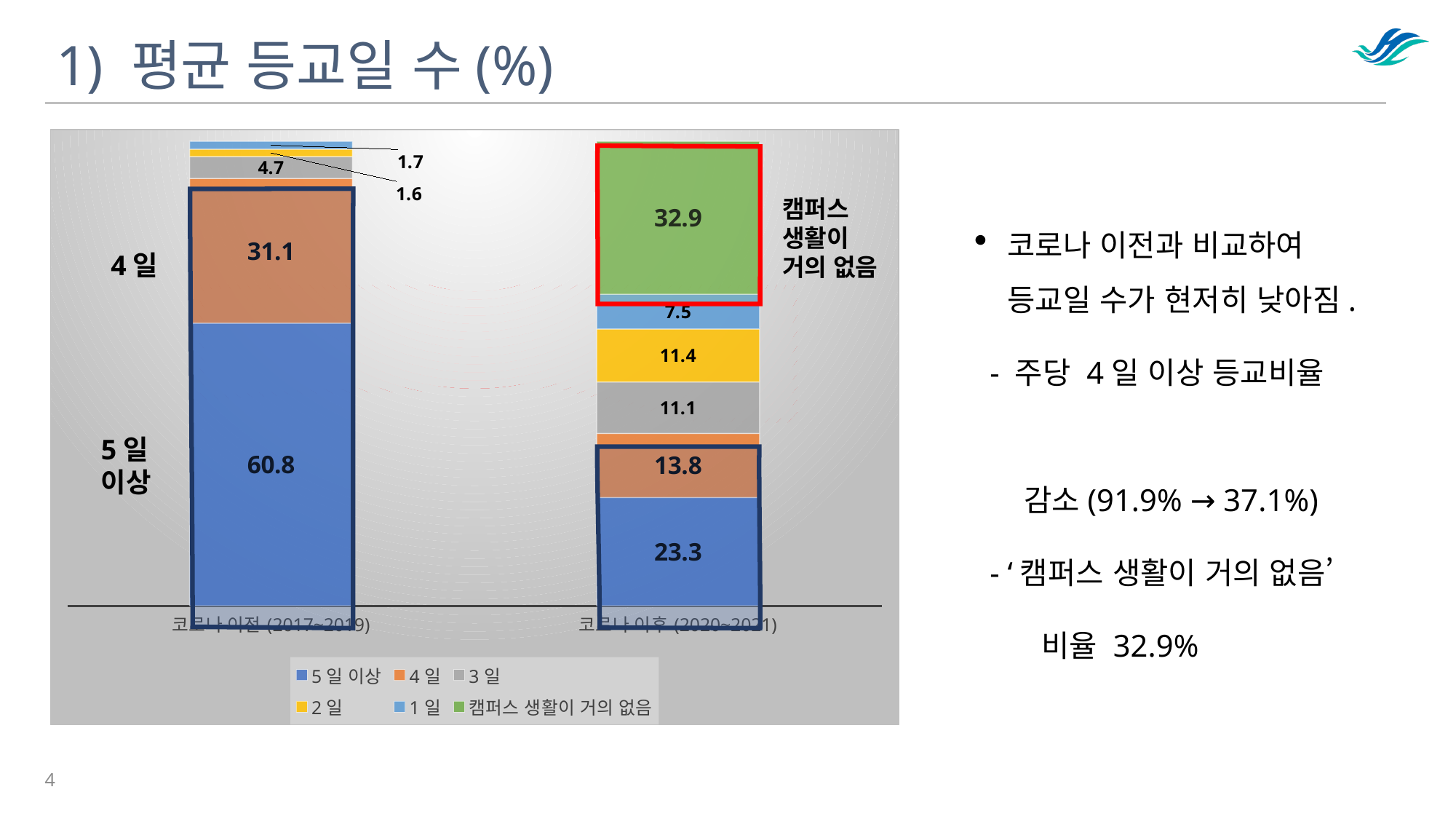
By how much did the 5 일 이상 value fall from 코로나 이전 (2017~2019) to 코로나 이후 (2020~2021)? 37.5 What is the value of the 5 일 이상 segment for 코로나 이전 (2017~2019)? 60.8 What is the value of the 4 일 segment for 코로나 이후 (2020~2021)? 13.8 In the 코로나 이후 (2020~2021) bar, which is larger: the 2 일 segment or the 3 일 segment? 2 일 How many series does the legend list? 6 What type of chart is shown on the slide? Stacked bar chart Which segment is the largest in the 코로나 이후 (2020~2021) bar? 캠퍼스 생활이 거의 없음 What is the value of the 캠퍼스 생활이 거의 없음 segment for 코로나 이후 (2020~2021)? 32.9 What is the value of the 3 일 segment for 코로나 이전 (2017~2019)? 4.7 What is the value of the 1 일 segment for 코로나 이후 (2020~2021)? 7.5 How many categories are shown on the x axis of the chart? 2 What is the difference between the 4 일 values for 코로나 이전 (2017~2019) and 코로나 이후 (2020~2021)? 17.3